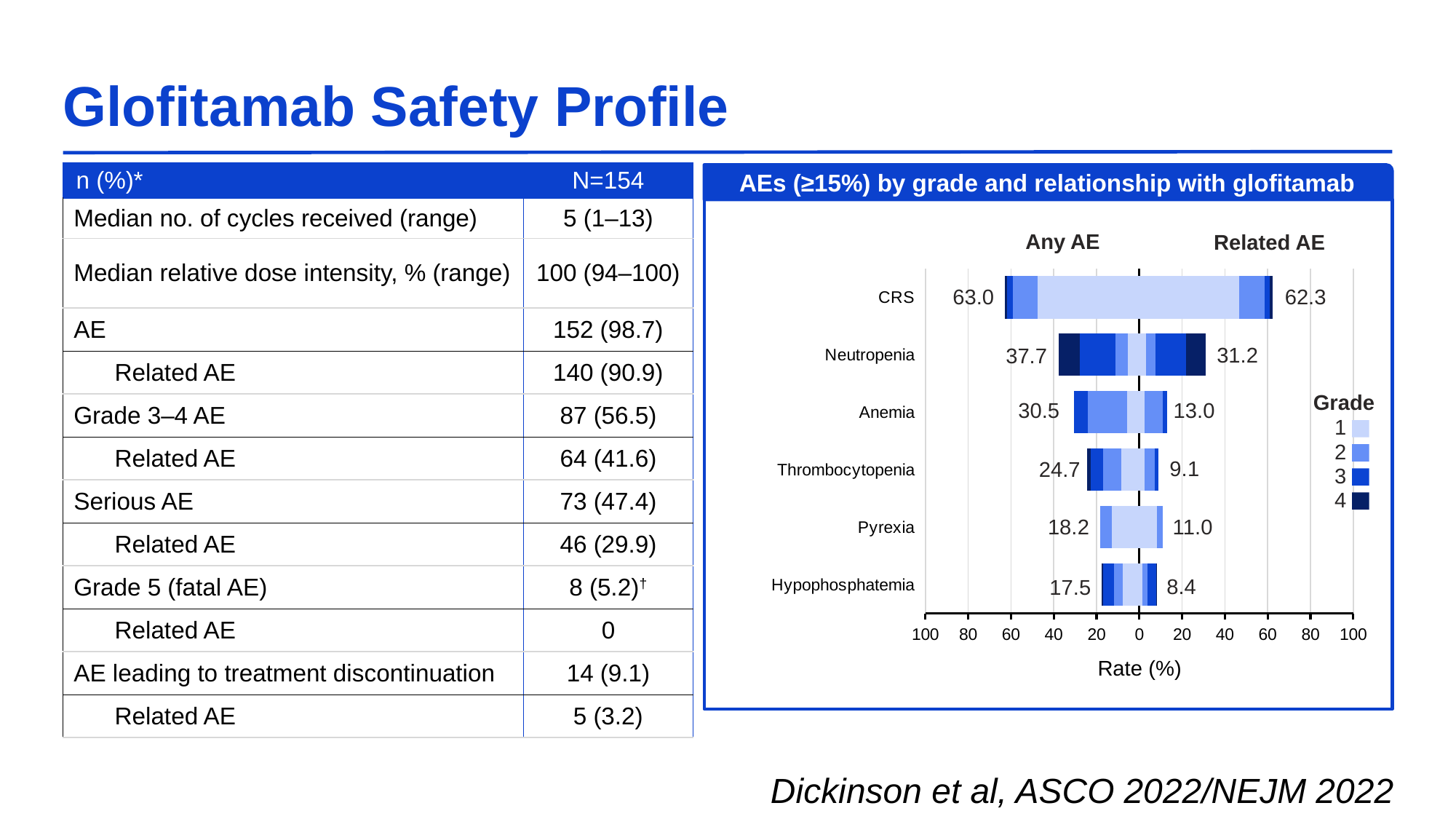
Which adverse event has the highest Any AE rate in the chart? CRS What is the Any AE rate for CRS in the chart? 63.0 How many grades does the chart legend list? 4 What is the Any AE rate for Thrombocytopenia in the chart? 24.7 How many adverse events are listed in the chart? 6 What is the Related AE rate for Hypophosphatemia in the chart? 8.4 Which adverse event has the lowest Related AE rate in the chart? Hypophosphatemia Which has a higher Related AE rate, Pyrexia or Thrombocytopenia? Pyrexia What is the difference between the Any AE rate and the Related AE rate for Anemia? 17.5 What kind of chart is shown on the slide? Bar chart What is the Related AE rate for Neutropenia in the chart? 31.2 What is the difference between the Any AE rate and the Related AE rate for Neutropenia? 6.5